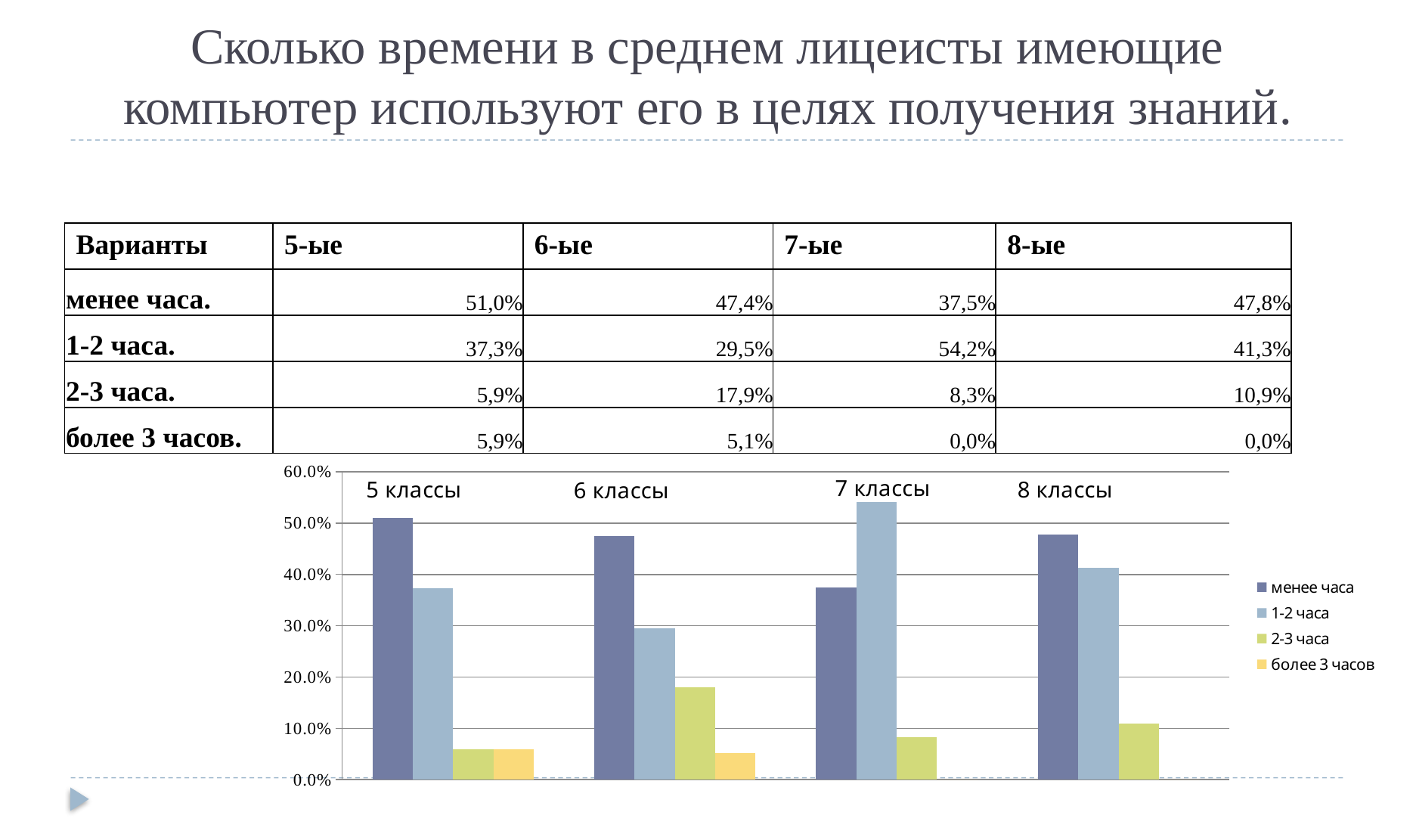
How many class groups are plotted along the x axis of the chart? 4 Which is larger: the "2-3 часа" value for 6 классы or for 8 классы? 6 классы What colour represents the "более 3 часов" series in the chart legend? yellow What is the difference between the "менее часа" and "1-2 часа" values for 5 классы? 13,7% Is the "менее часа" value for 8 классы greater or less than 40%? greater Which class group has the highest "1-2 часа" bar? 7 классы How many series does the chart legend list? 4 Which class group has the lowest "менее часа" bar? 7 классы What kind of chart is shown on the slide? bar chart What is the value for "1-2 часа" for 7 классы? 54,2% What is the value for "менее часа" for 5 классы? 51,0% What is the value for "более 3 часов" for 8 классы? 0,0%